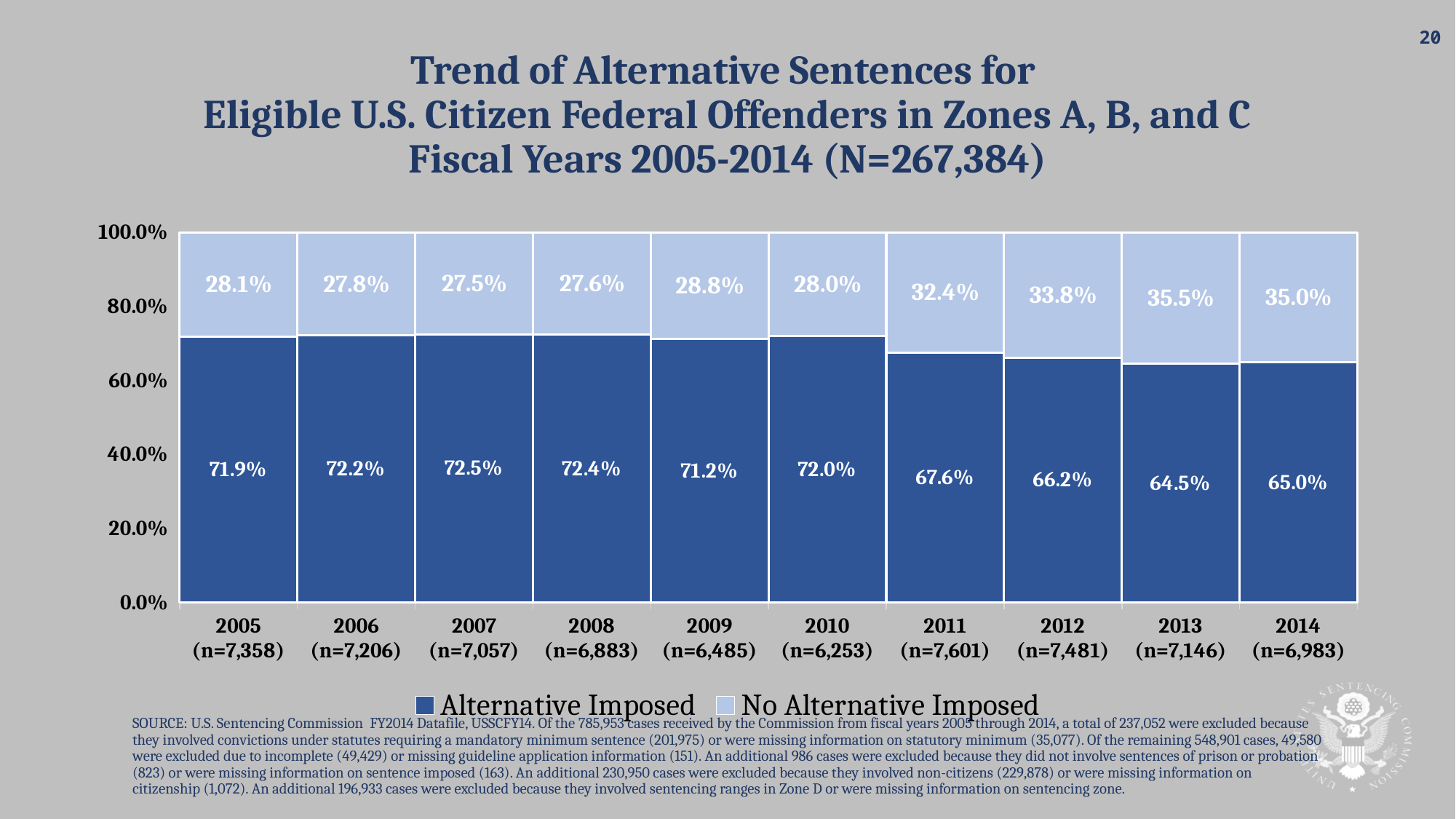
What percentage of offenders had no alternative imposed in 2013? 35.5% What is the value for Alternative Imposed in 2011? 67.6% How many fiscal years are shown on the x axis? 10 What percentage of offenders had an alternative imposed in 2005? 71.9% What is the difference between the Alternative Imposed percentage in 2007 and in 2013? 8.0% Which is larger: the No Alternative Imposed share in 2012 or in 2009? 2012 How many series does the legend list? 2 What is the number of cases (n) shown for 2011? 7,601 Which fiscal year has the highest percentage of Alternative Imposed? 2007 Which fiscal year has the lowest percentage of Alternative Imposed? 2013 What kind of chart is shown on the slide? Stacked bar chart Does the Alternative Imposed percentage generally rise or fall from 2010 to 2013? Fall